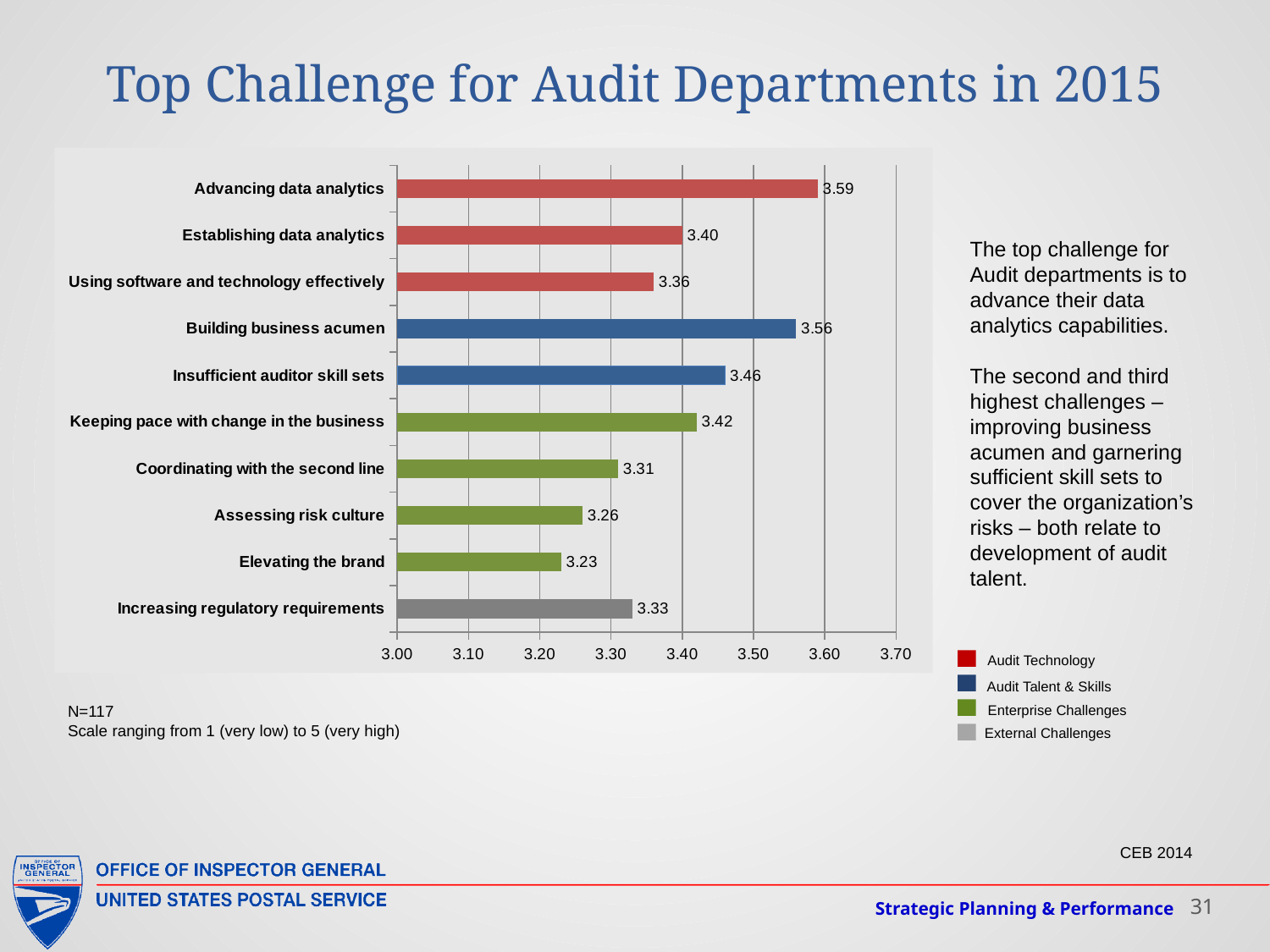
What is the value for Elevating the brand? 3.23 How many categories are shown in the chart? 10 Which category has the lowest value? Elevating the brand What kind of chart is shown on the slide? Bar chart Which category has the highest value? Advancing data analytics How many entries does the legend list? 4 Is the value for Coordinating with the second line greater or less than 3.40? less What is the value for Building business acumen? 3.56 What is the value for Advancing data analytics? 3.59 What is the difference between the values for Advancing data analytics and Establishing data analytics? 0.19 Which is larger, the value for Insufficient auditor skill sets or the value for Keeping pace with change in the business? Insufficient auditor skill sets What is the value for Increasing regulatory requirements? 3.33